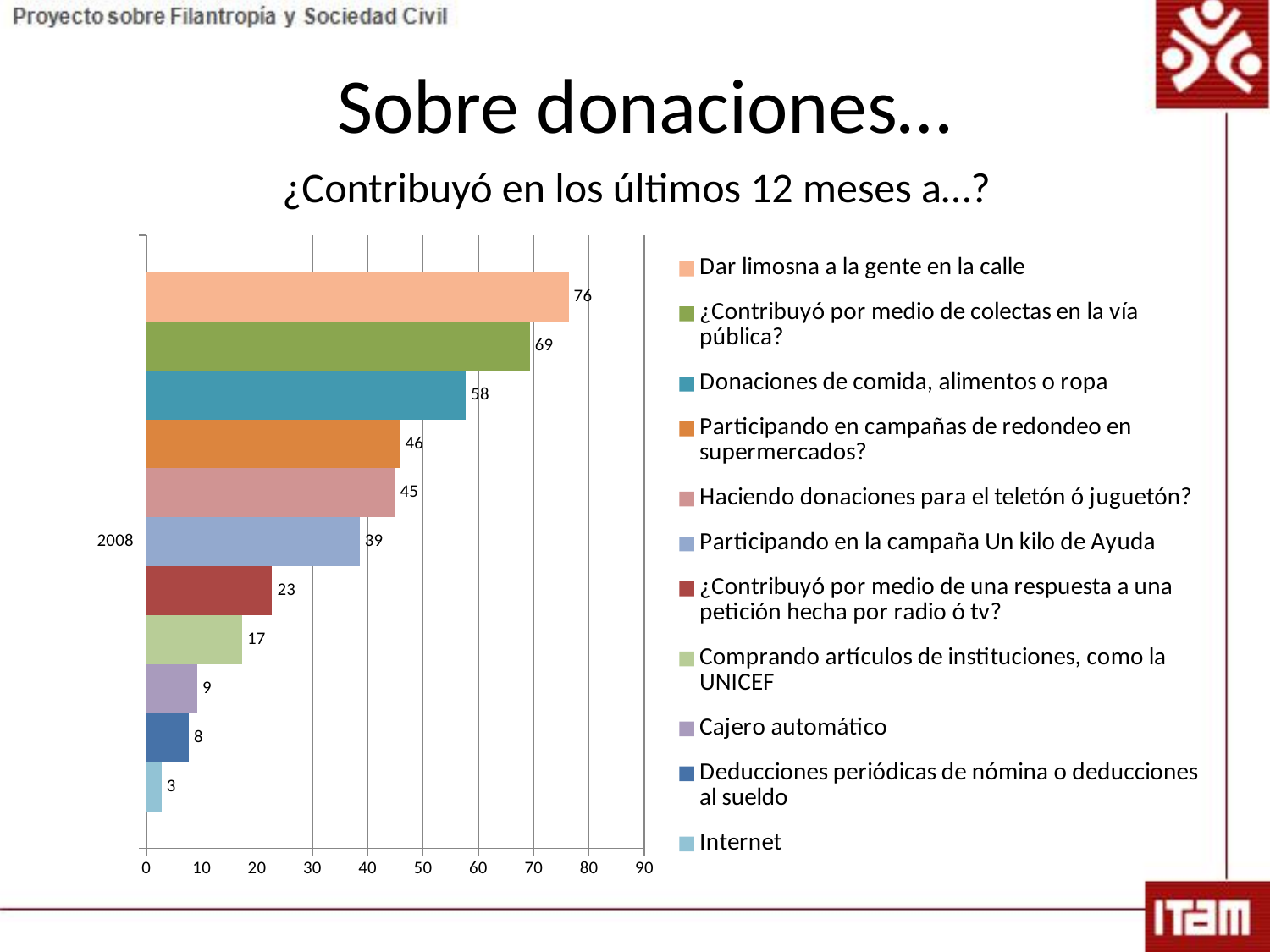
What is the difference between the values for "Participando en campañas de redondeo en supermercados?" and "Haciendo donaciones para el teletón ó juguetón?"? 1 What is the difference between the values for "Dar limosna a la gente en la calle" and "¿Contribuyó por medio de colectas en la vía pública?"? 7 What year label appears on the vertical axis of the chart? 2008 Which is larger: the value for "Cajero automático" or the value for "Deducciones periódicas de nómina o deducciones al sueldo"? Cajero automático What value is shown for "Participando en la campaña Un kilo de Ayuda"? 39 What kind of chart is shown on the slide? Bar chart How many series does the legend list? 11 Which series has the lowest value? Internet What value is shown for "Dar limosna a la gente en la calle"? 76 What value is shown for "Donaciones de comida, alimentos o ropa"? 58 Which series has the highest value? Dar limosna a la gente en la calle What value is shown for "Internet"? 3